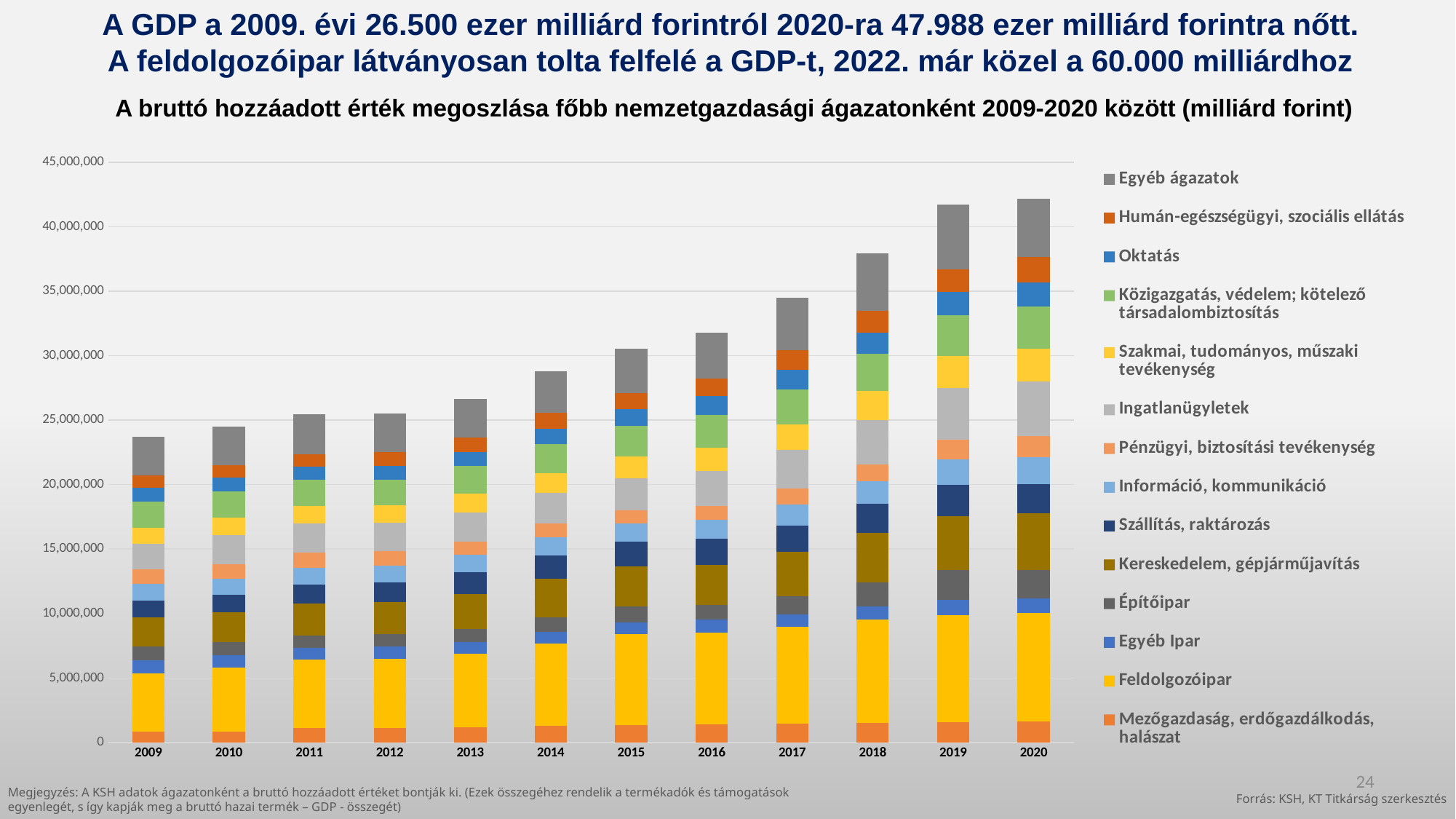
Do the total bar values generally rise or fall from 2009 to 2020? rise What kind of chart is shown on the slide? Stacked bar chart How many series does the chart's legend list? 14 Is the total value for 2009 greater or less than 25,000,000? less Which year has a larger total bar, 2013 or 2018? 2018 Is the total value for 2014 greater or less than 30,000,000? less Is the total value for 2020 greater or less than 40,000,000? greater How many years (categories) are shown on the x axis of the chart? 12 Which series is shown at the bottom of each stacked bar, according to the legend? Mezőgazdaság, erdőgazdálkodás, halászat Which year has the lowest total bar in the chart? 2009 Which year has the highest total bar in the chart? 2020